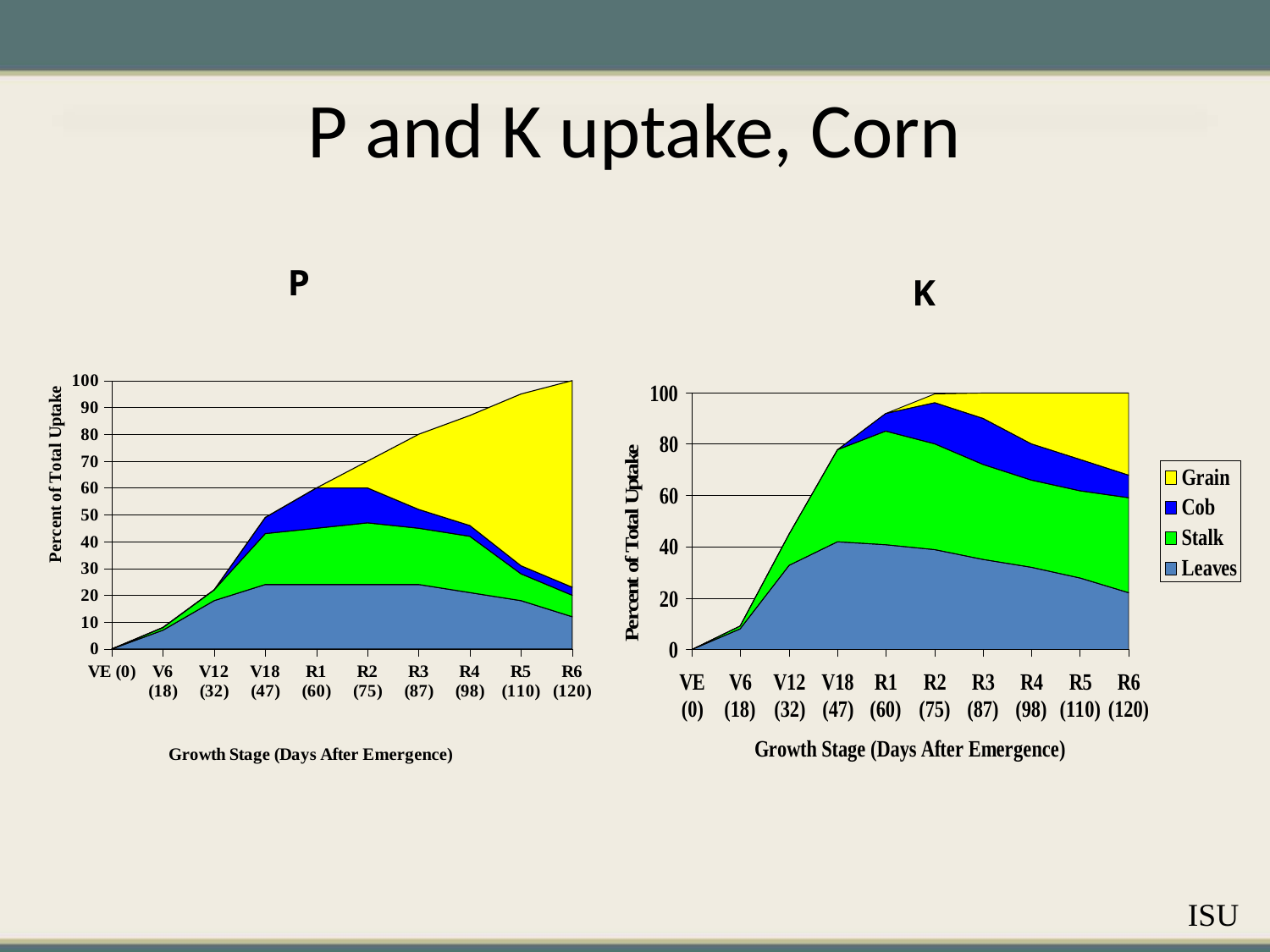
In the K chart, what is the total percent of uptake at VE (0)? 0 In the K chart, is the total percent of uptake at V12 (32) greater or less than 40? less Which colour represents Grain in the legend? yellow What is the title of the y axis on the K chart? Percent of Total Uptake How many series does the legend list? 4 How many growth stages are shown on the x axis of the K chart? 10 What kind of chart is the P chart? stacked area chart In the P chart, what is the total percent of uptake at R6 (120)? 100 In the P chart, is the value for Leaves at R2 (75) greater or less than 30? less In the K chart, is the value for Leaves at R4 (98) greater or less than 40? less In the P chart, does the total percent of uptake rise or fall from VE (0) to R6 (120)? rise